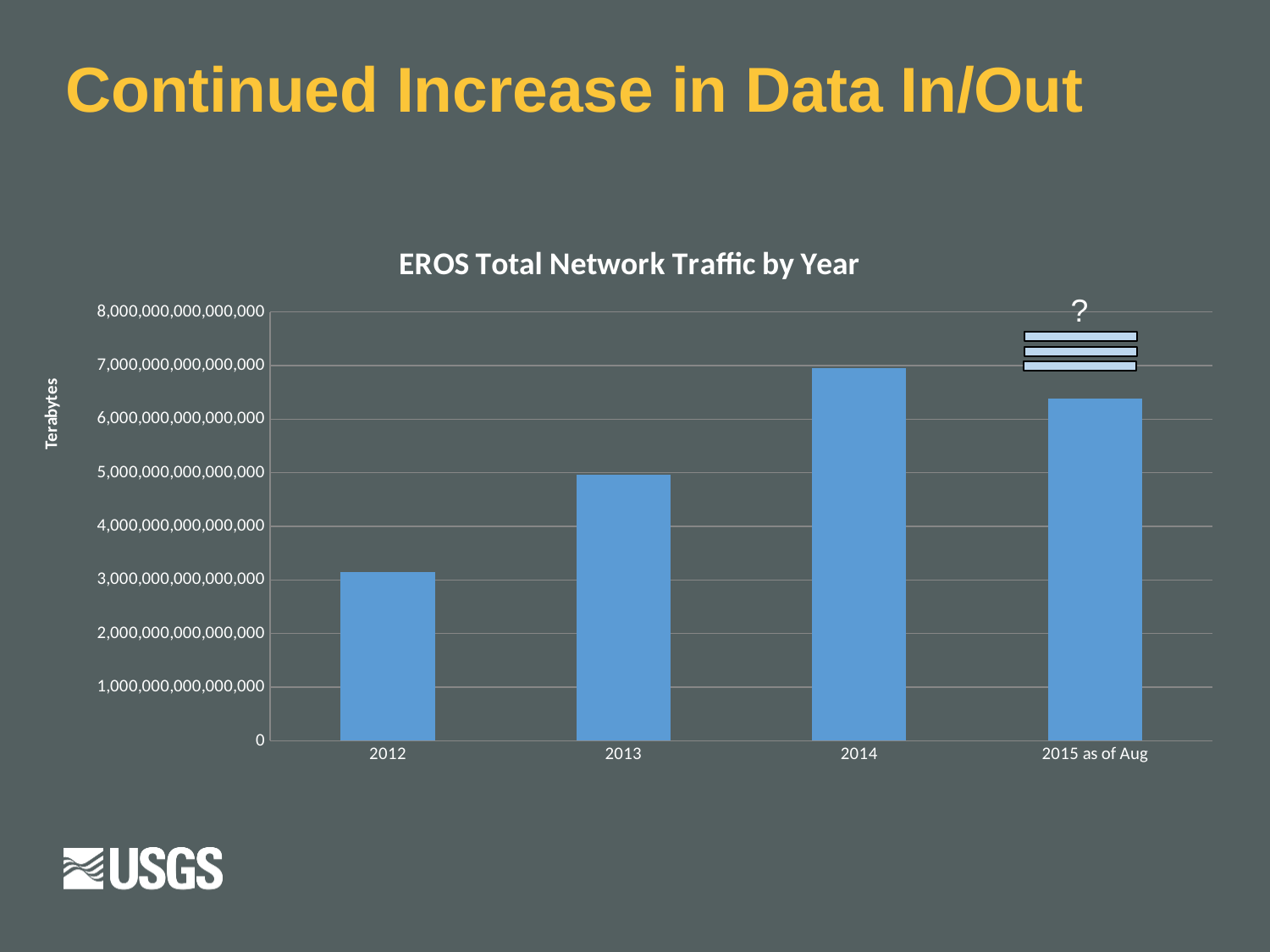
What is the title of the chart? EROS Total Network Traffic by Year What type of chart is shown on the slide? Bar chart Which is larger, the value for 2012 or the value for 2013? 2013 Which year has the highest network traffic in the chart? 2014 Is the value for 2013 greater or less than 4,000,000,000,000,000? greater Which is larger, the value for 2014 or the value for 2015 as of Aug? 2014 How many bars (categories) are plotted in the chart? 4 How do the values change from 2012 through 2014 in the chart? They rise each year Is the value for 2012 greater or less than 4,000,000,000,000,000? less What unit is shown on the vertical axis label of the chart? Terabytes Which year has the lowest network traffic in the chart? 2012 Is the value for 2015 as of Aug greater or less than 6,000,000,000,000,000? greater